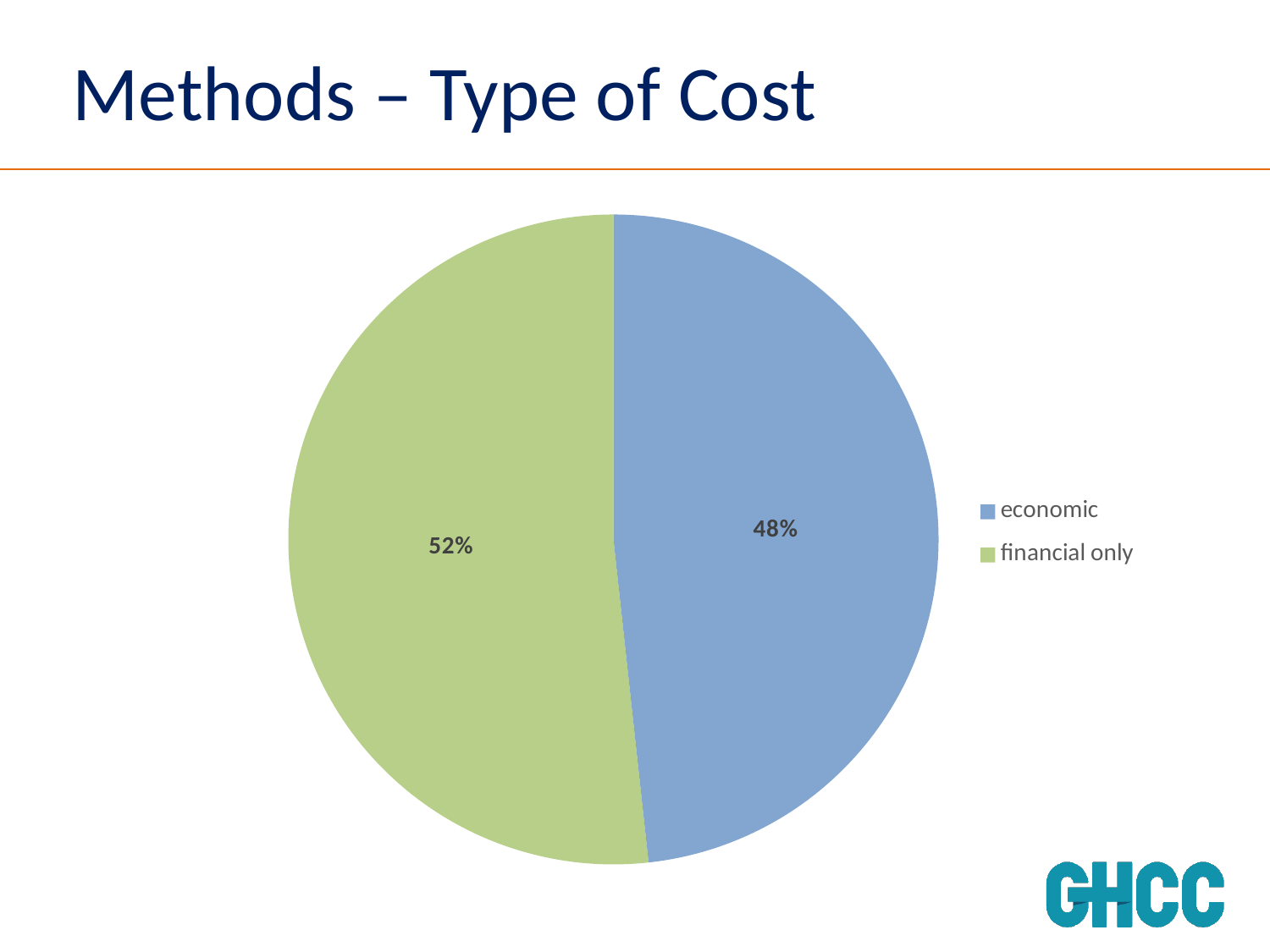
Which colour represents "financial only" in the pie chart? green Is the share for "economic" larger or smaller than the share for "financial only"? smaller What is the title of the slide containing the chart? Methods – Type of Cost Which category has the larger share of the pie? financial only What share of the pie is labelled "financial only"? 52% How many entries does the legend list? 2 How many slices does the pie chart have? 2 What share of the pie is labelled "economic"? 48% What kind of chart is shown on the slide? pie chart Which category has the smaller share of the pie? economic What is the difference in percentage points between the "financial only" and "economic" slices? 4